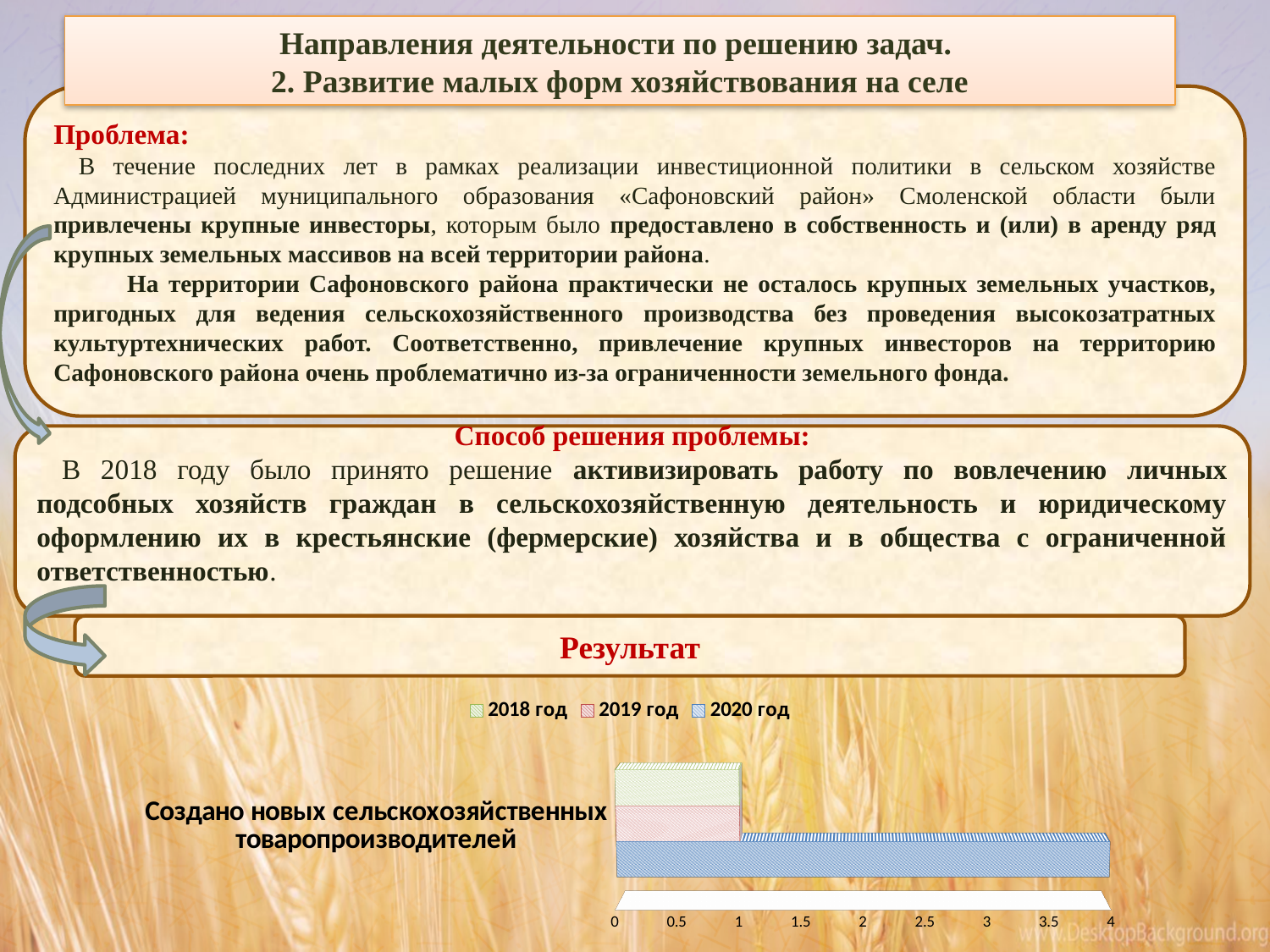
How many categories are plotted in the chart? 1 What is the value for 2018 год on the chart? 1 What is the category label shown next to the chart? Создано новых сельскохозяйственных товаропроизводителей What kind of chart is shown at the bottom of the slide? bar chart Is the value for 2018 год greater or less than 2? less Which series are listed in the chart legend? 2018 год, 2019 год, 2020 год Is the value for 2020 год greater or less than 3? greater What is the difference between the values for 2020 год and 2019 год? 3 What is the value for 2020 год on the chart? 4 Which is larger, the value for 2020 год or the value for 2019 год? 2020 год Which year has the highest value for new agricultural producers created? 2020 год How many series does the chart legend list? 3